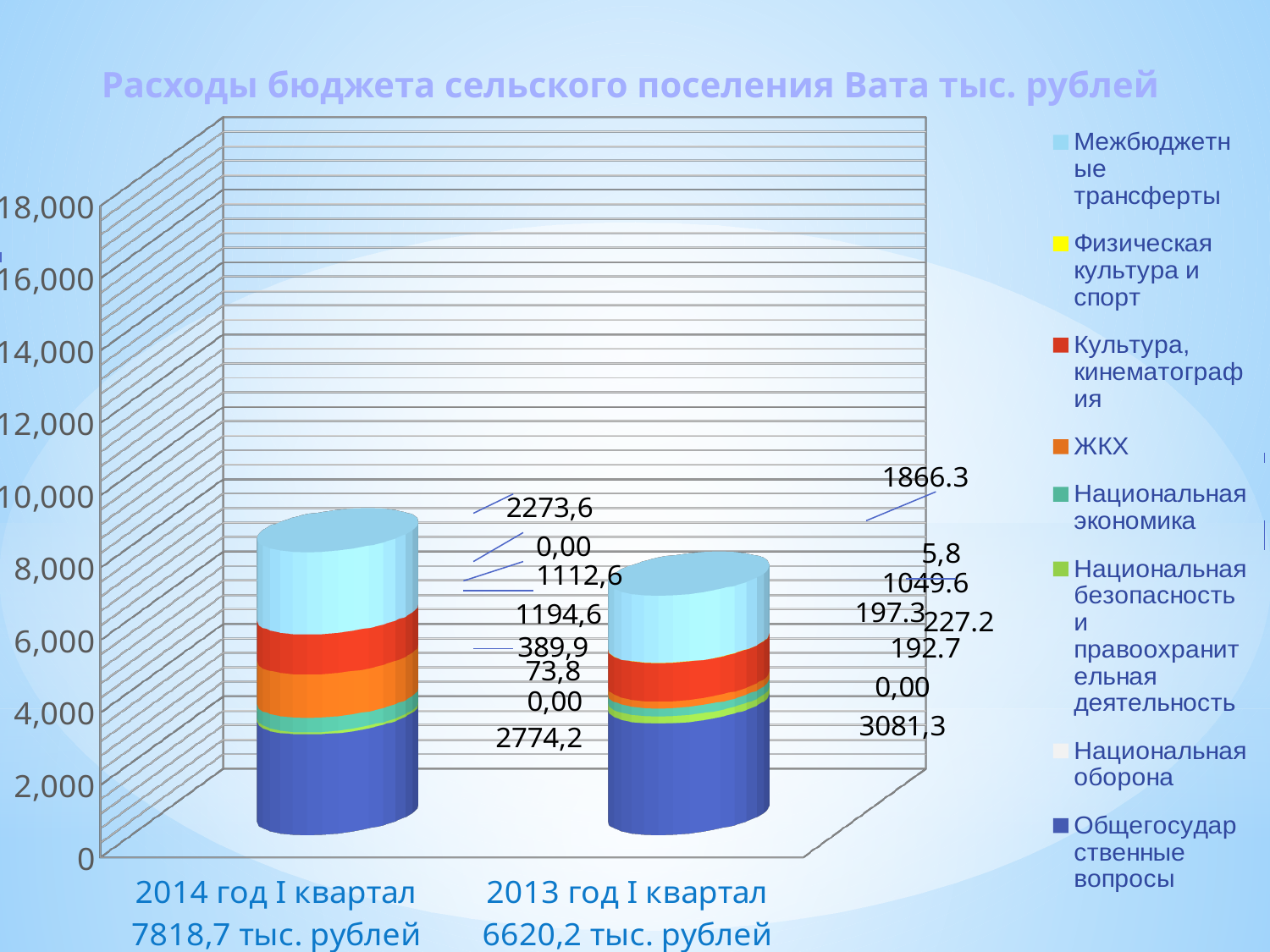
What is the value of Общегосударственные вопросы for 2013 год I квартал? 3081,3 What is the value of Общегосударственные вопросы for 2014 год I квартал? 2774,2 How many categories (bars) are plotted on the chart? 2 What is the value of Межбюджетные трансферты for 2014 год I квартал? 2273,6 What is the difference between the totals for 2014 год I квартал and 2013 год I квартал? 1198,5 What is the total of the stacked bar for 2014 год I квартал? 7818,7 тыс. рублей What kind of chart is shown on the slide? stacked bar chart How many series does the legend list? 8 Which bar has the larger total, 2014 год I квартал or 2013 год I квартал? 2014 год I квартал What is the title of the chart? Расходы бюджета сельского поселения Вата тыс. рублей What is the total of the stacked bar for 2013 год I квартал? 6620,2 тыс. рублей What is the value of Межбюджетные трансферты for 2013 год I квартал? 1866.3